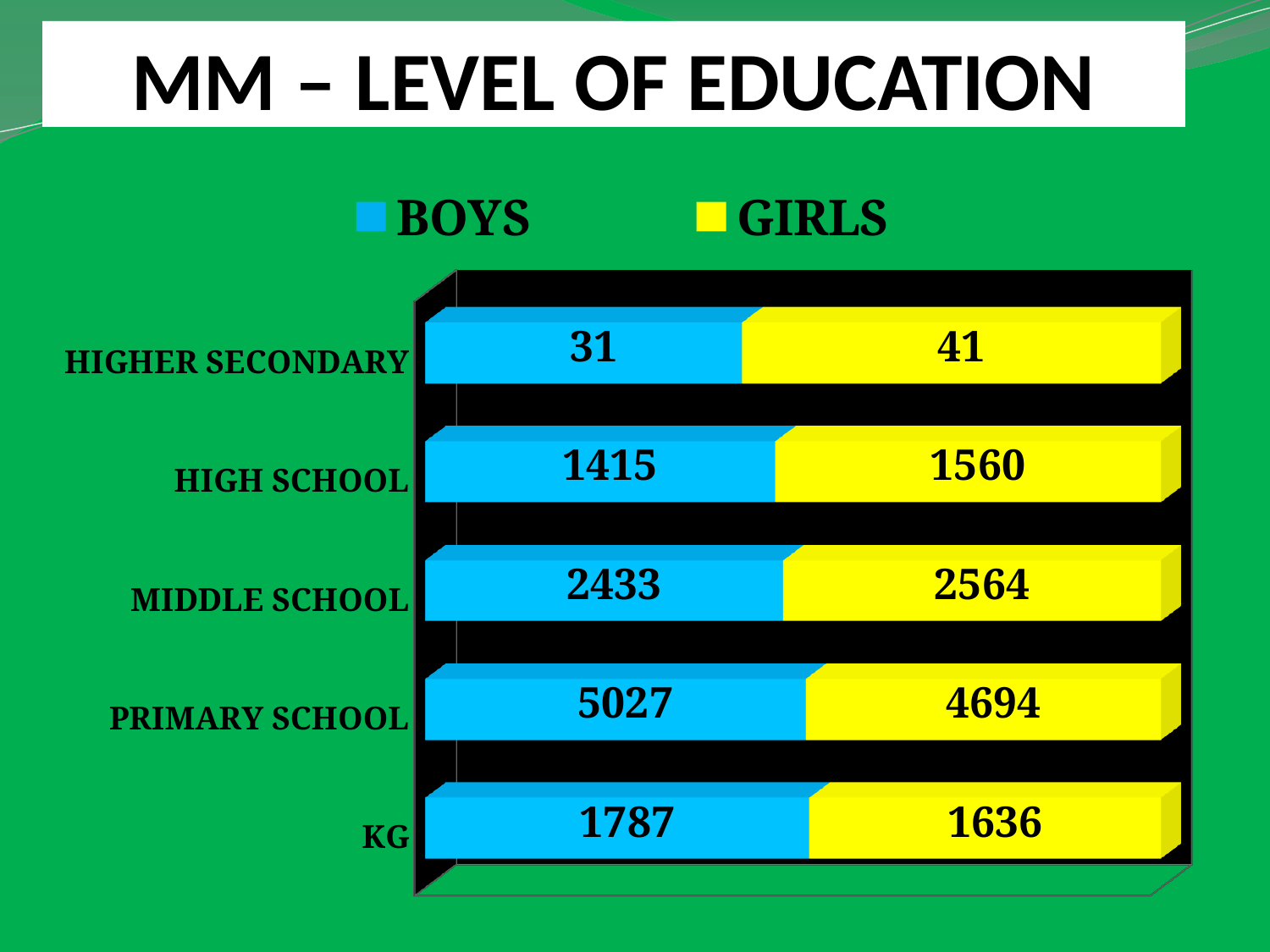
What is the difference between Girls and Boys at Middle School? 131 How many levels of education are shown in the chart? 5 Which is larger at KG, the value for Boys or the value for Girls? Boys What is the total of Boys and Girls for the Primary School bar? 9721 What is the value for Boys at KG? 1787 What is the value for Girls at High School? 1560 How many series does the legend list? 2 What is the value for Boys at Primary School? 5027 What kind of chart is shown on the slide? Stacked bar chart Which level of education has the highest value for Boys? Primary School What is the value for Girls at Higher Secondary? 41 Which level of education has the lowest value for Girls? Higher Secondary